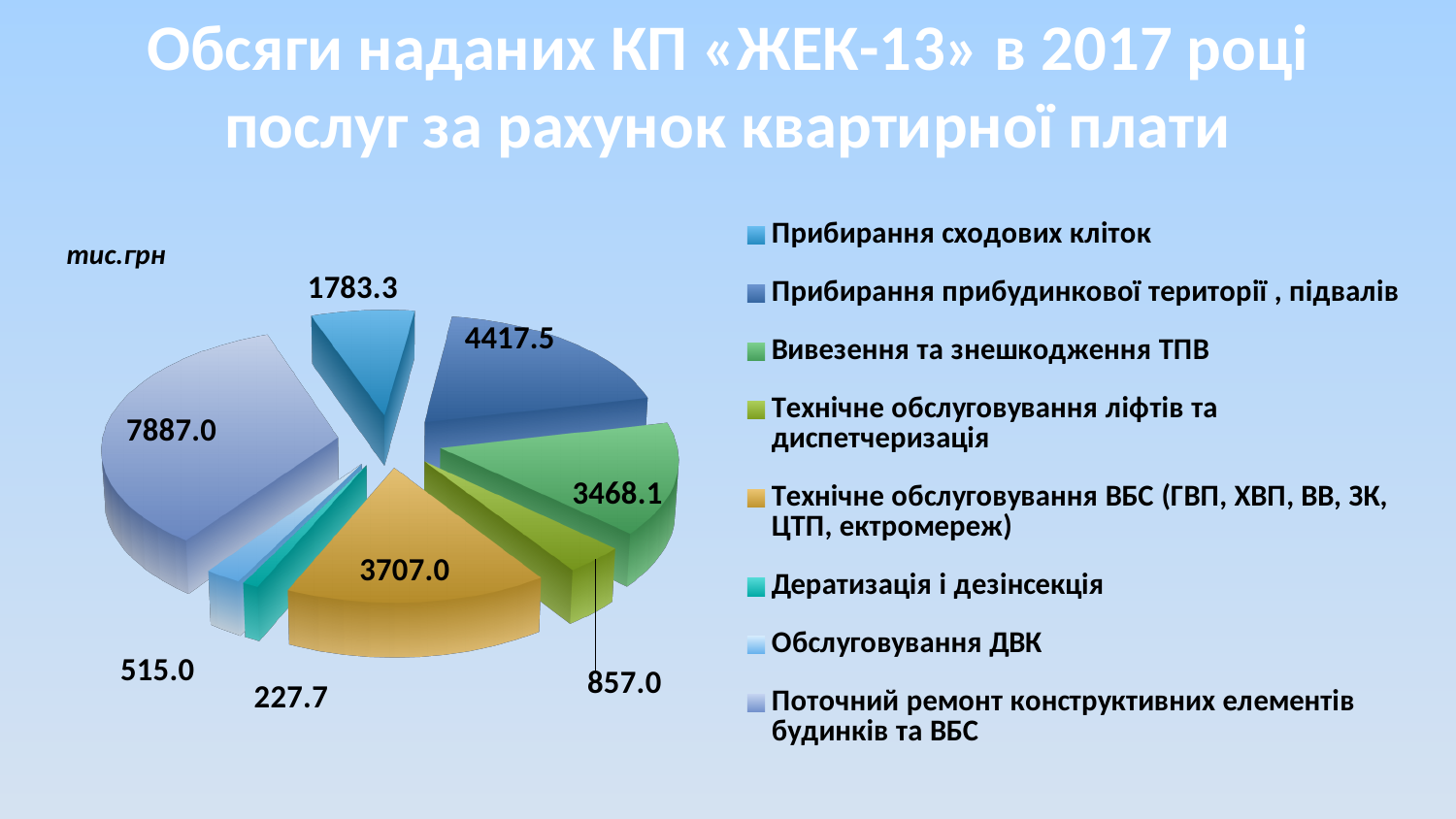
Which is larger: Технічне обслуговування ВБС or Технічне обслуговування ліфтів та диспетчеризація? Технічне обслуговування ВБС How many slices does the pie chart have? 8 What is the value for Прибирання прибудинкової території, підвалів? 4417.5 What is the smallest value labelled on the pie chart? 227.7 What is the value for Прибирання сходових кліток? 1783.3 What kind of chart is shown on the slide? pie chart How many entries does the legend list? 8 What is the value for Вивезення та знешкодження ТПВ? 3468.1 What is the value for Поточний ремонт конструктивних елементів будинків та ВБС? 7887.0 What is the difference between the values for Прибирання прибудинкової території, підвалів and Вивезення та знешкодження ТПВ? 949.4 Which category has the largest slice of the pie? Поточний ремонт конструктивних елементів будинків та ВБС What is the value for Технічне обслуговування ВБС (ГВП, ХВП, ВВ, ЗК, ЦТП, ектромереж)? 3707.0